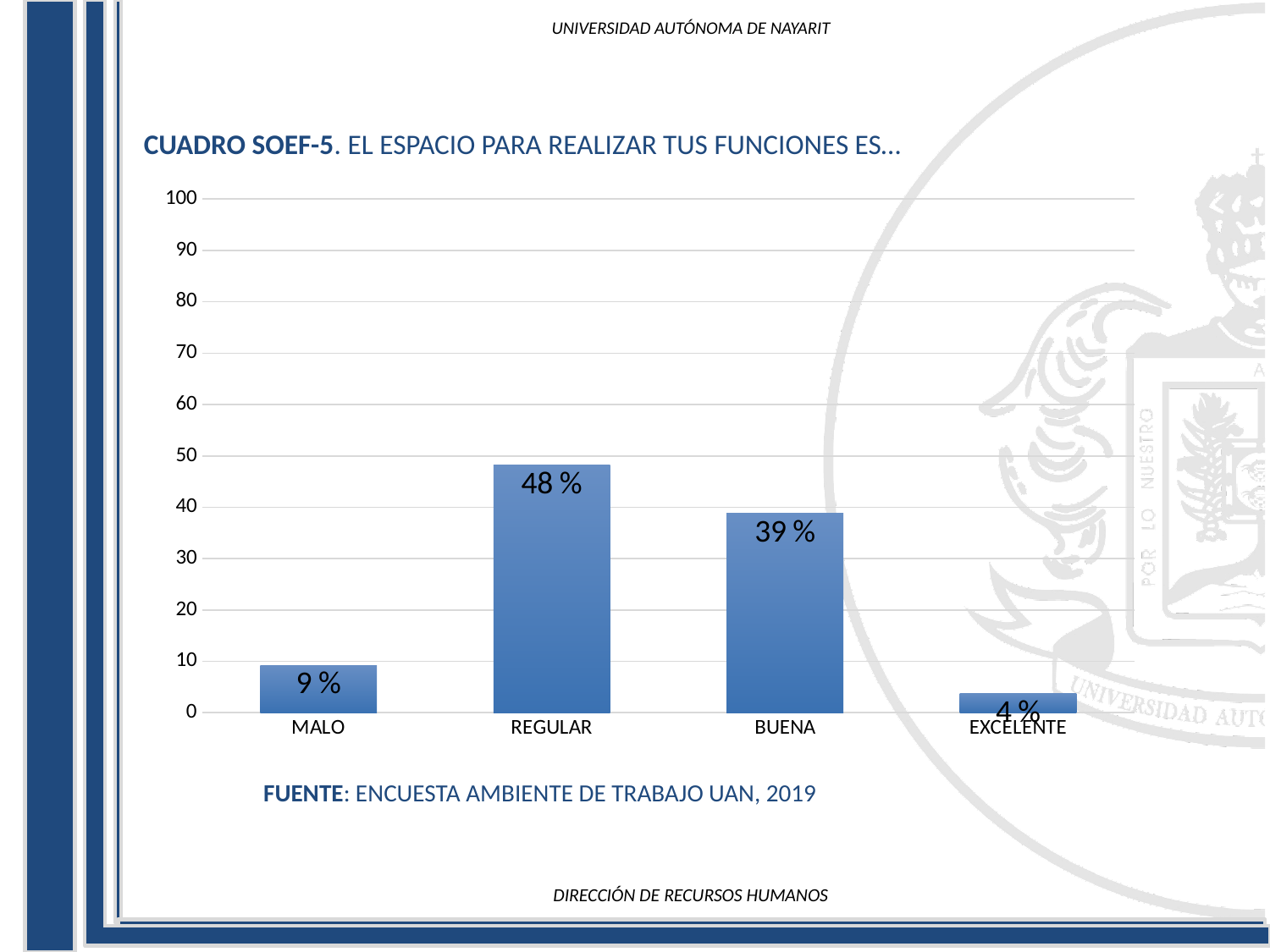
What is the value for BUENA? 39 % What is the value for EXCELENTE? 4 % Which is larger, the value for MALO or the value for EXCELENTE? MALO What kind of chart is shown on the slide? bar chart What is the value for REGULAR? 48 % Is the value for BUENA greater or less than 30? greater What is the source cited below the chart? ENCUESTA AMBIENTE DE TRABAJO UAN, 2019 What is the value for MALO? 9 % How many categories are shown on the x axis? 4 Which category has the lowest value? EXCELENTE What is the difference between the values for REGULAR and BUENA? 9 % Which category has the highest value? REGULAR